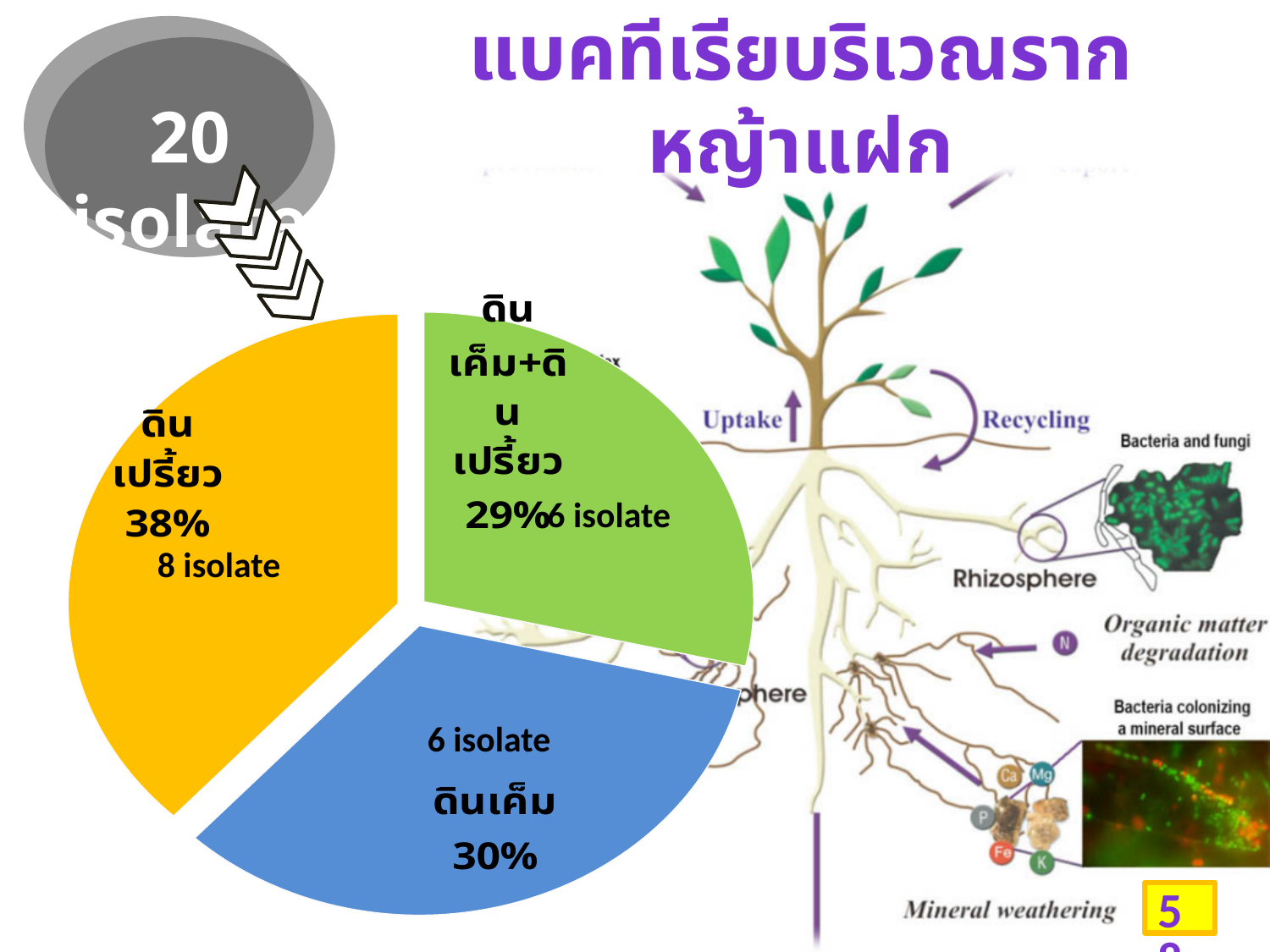
What colour is the ดินเค็ม slice of the pie chart? Blue What percentage of the pie is the ดินเปรี้ยว slice? 38% Which slice of the pie chart is the largest? ดินเปรี้ยว What percentage of the pie is the ดินเค็ม+ดินเปรี้ยว slice? 29% How many slices does the pie chart have? 3 How many isolates are labelled for the ดินเค็ม slice? 6 isolate Which slice has the larger share, ดินเค็ม or ดินเค็ม+ดินเปรี้ยว? ดินเค็ม What percentage of the pie is the ดินเค็ม slice? 30% How many isolates are labelled for the ดินเปรี้ยว slice? 8 isolate What is the difference in percentage points between the ดินเปรี้ยว slice and the ดินเค็ม slice? 8 What kind of chart is shown on the slide? Pie chart Which slice of the pie chart is the smallest? ดินเค็ม+ดินเปรี้ยว